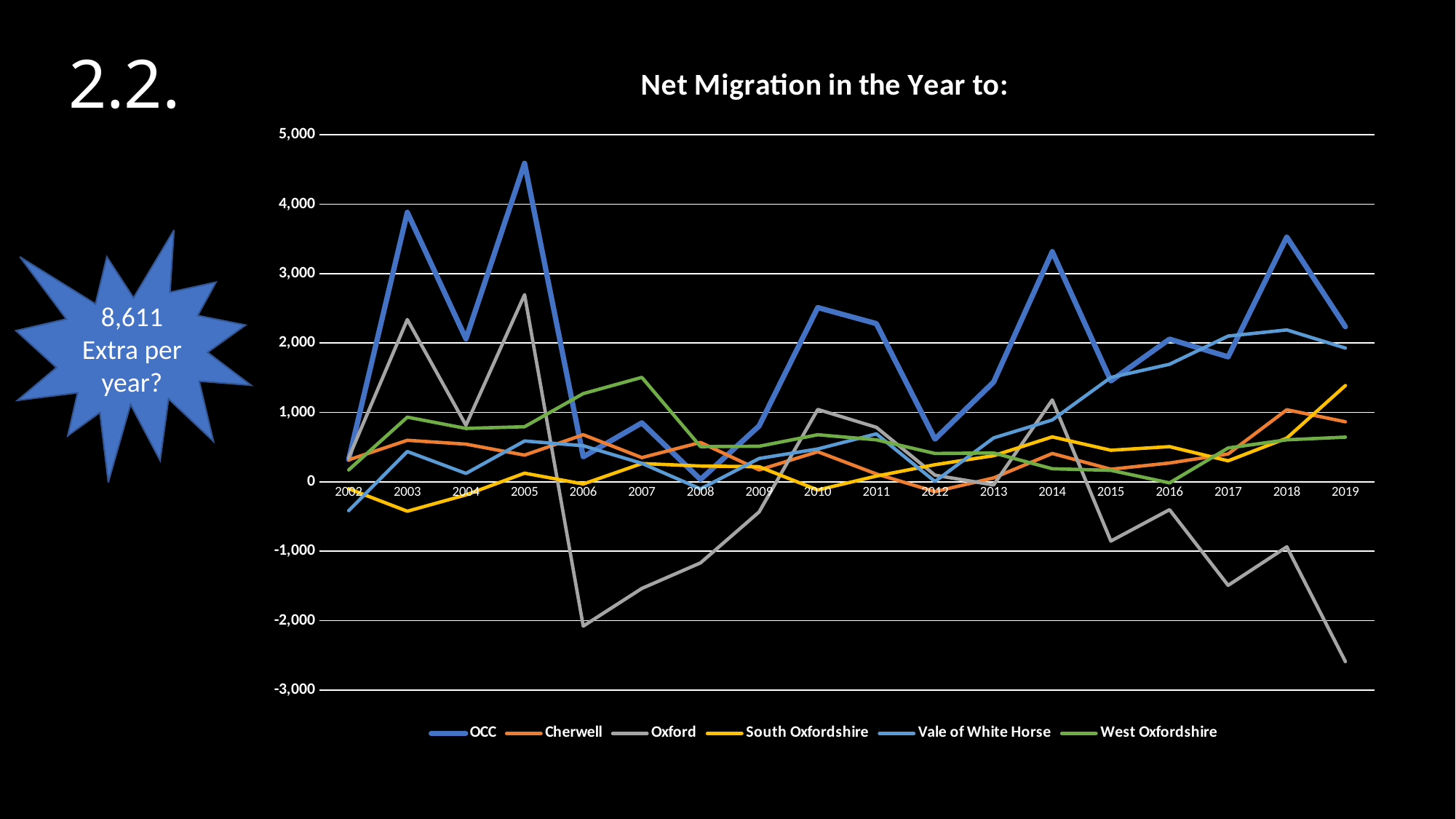
In which year does the Oxford series reach its lowest value? 2019 In which year does the OCC series reach its highest value? 2005 In 2019, which is larger: the value for South Oxfordshire or the value for Cherwell? South Oxfordshire Is the value for Oxford in 2019 greater or less than -2,000? less What kind of chart is shown on the slide? Line chart How many series does the legend list? 6 How many years are plotted along the x axis? 18 Is the value for OCC in 2005 greater or less than 4,000? greater Does the Oxford series rise or fall overall from 2014 to 2019? Fall In 2003, which is larger: the value for OCC or the value for Oxford? OCC What is the title of the chart? Net Migration in the Year to: Is the value for West Oxfordshire in 2007 greater or less than 1,000? greater